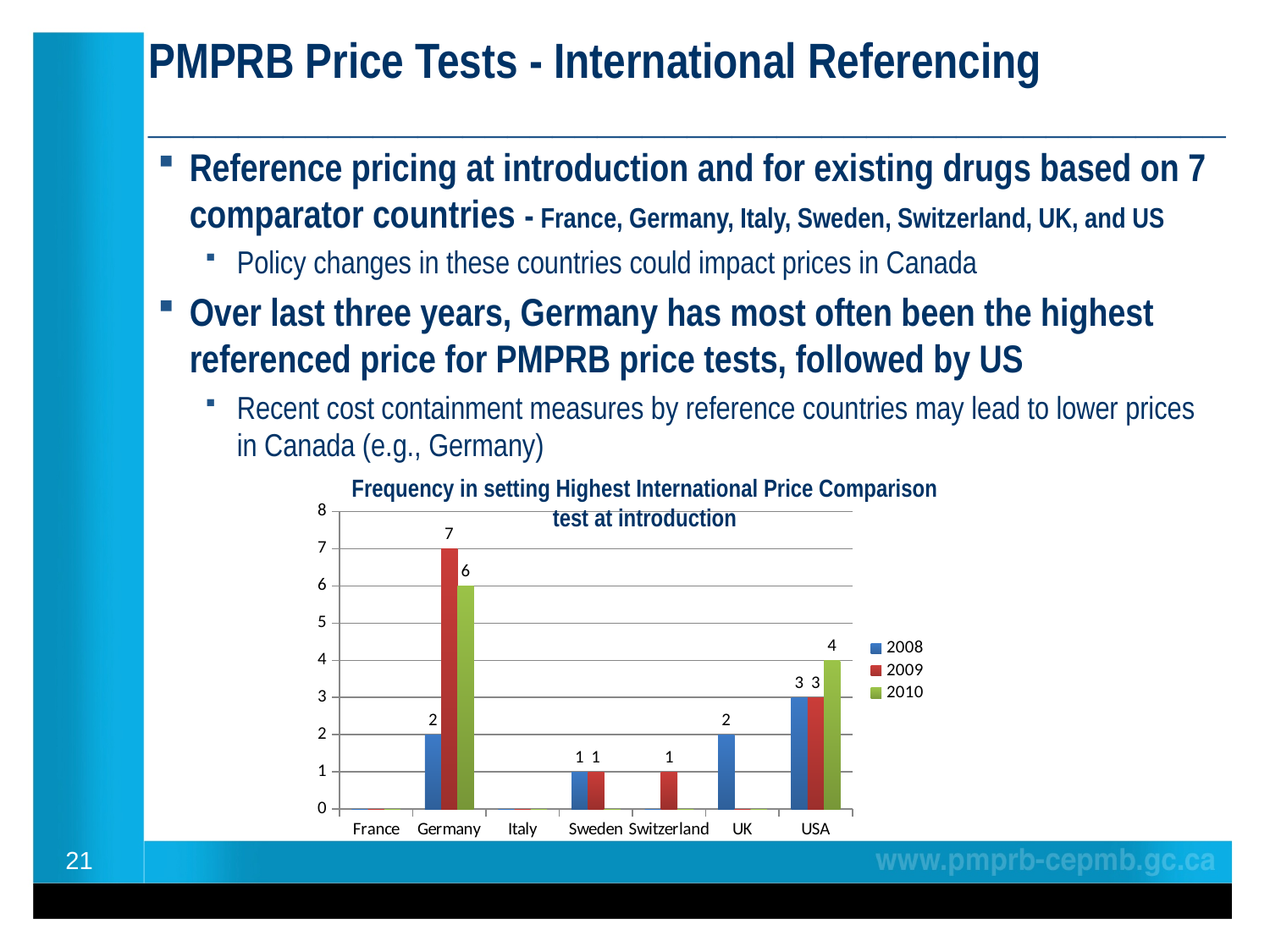
How many series does the chart legend list? 3 What kind of chart is shown on the slide? Bar chart What is the value for UK in the 2008 series? 2 What is the value for USA in the 2010 series? 4 What is the value for Switzerland in the 2009 series? 1 Which country has the highest value in the 2009 series? Germany What is the difference between USA's 2010 value and its 2008 value? 1 What is the value for Germany in the 2009 series? 7 What is the difference between Germany's 2009 value and its 2010 value? 1 How many countries are shown on the x axis of the chart? 7 Which is larger in the 2010 series, Germany or USA? Germany What is the title of the chart? Frequency in setting Highest International Price Comparison test at introduction